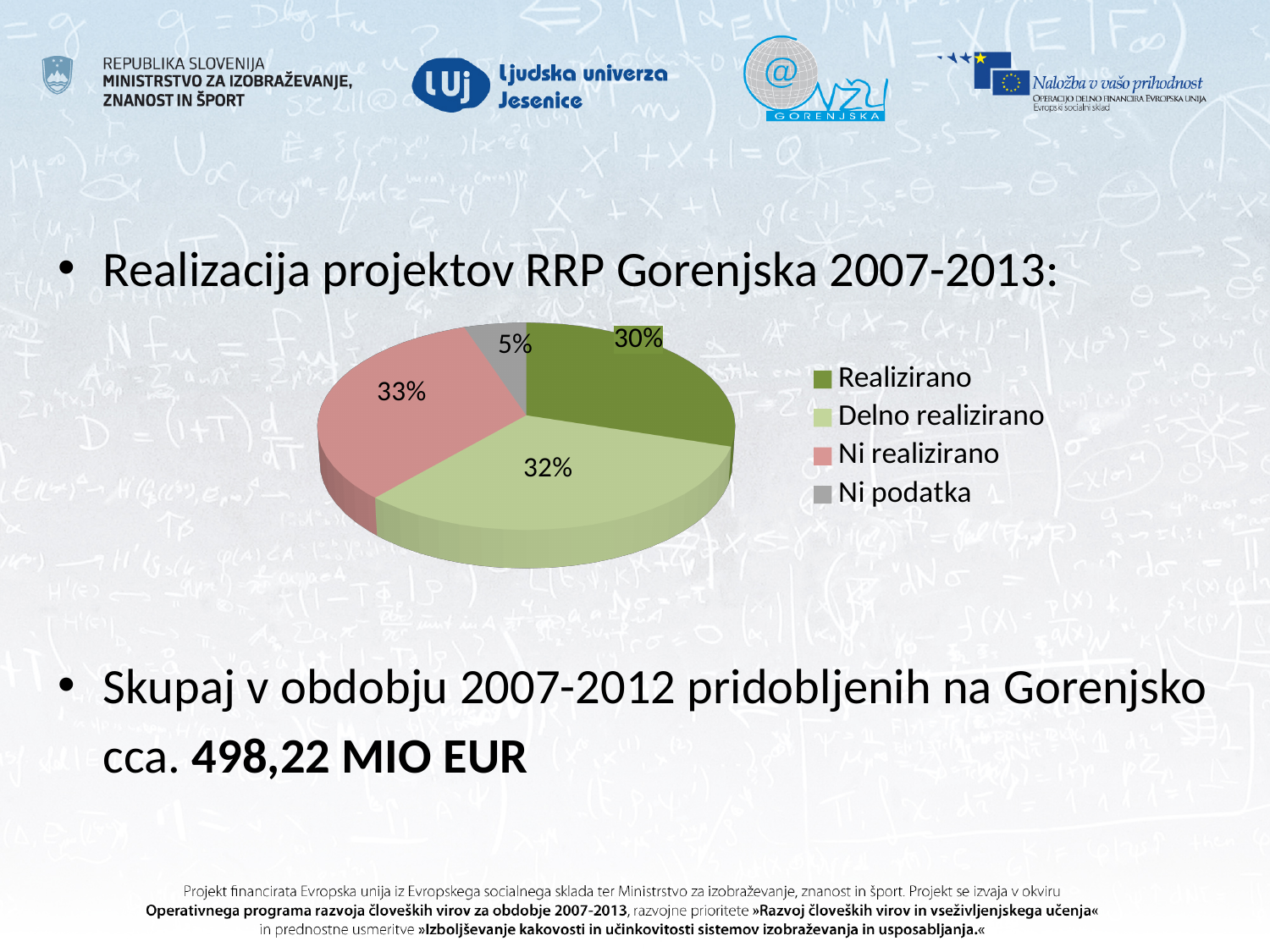
What share of the pie does "Realizirano" represent? 30% What colour is the "Ni realizirano" slice in the pie chart? pink What share of the pie does "Ni realizirano" represent? 33% What share of the pie does "Ni podatka" represent? 5% What is the difference between the shares of "Ni realizirano" and "Ni podatka"? 28% Which category has the smallest slice of the pie? Ni podatka Which is larger, the share of "Realizirano" or the share of "Ni podatka"? Realizirano What kind of chart is shown on the slide? pie chart Which legend entry is shown in grey? Ni podatka Which category has the largest slice of the pie? Ni realizirano How many categories does the pie chart have? 4